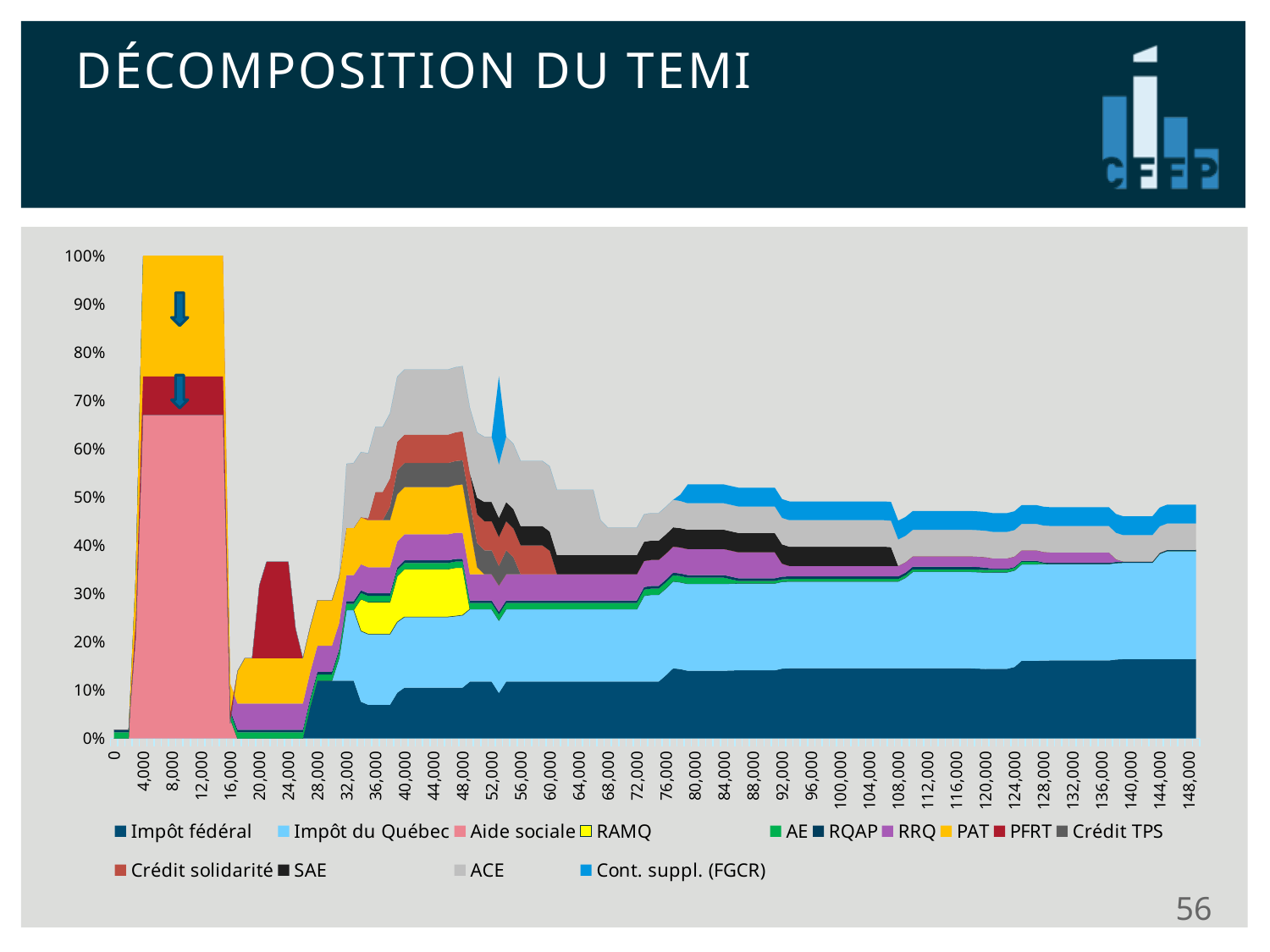
Is the stacked total at 148,000 greater or less than 50%? less Is the stacked total at 80,000 greater or less than 60%? less Is the stacked total higher at 8,000 or at 148,000? 8,000 Which series is shown in yellow in the legend? RAMQ Is the stacked total at 40,000 greater or less than 70%? greater What is the highest value shown on the x axis? 148,000 Between 12,000 and 16,000 on the x axis, does the stacked total rise or fall? fall How many series does the legend list? 14 What kind of chart is shown on the slide? Stacked area chart What is the title of the slide containing the chart? DÉCOMPOSITION DU TEMI